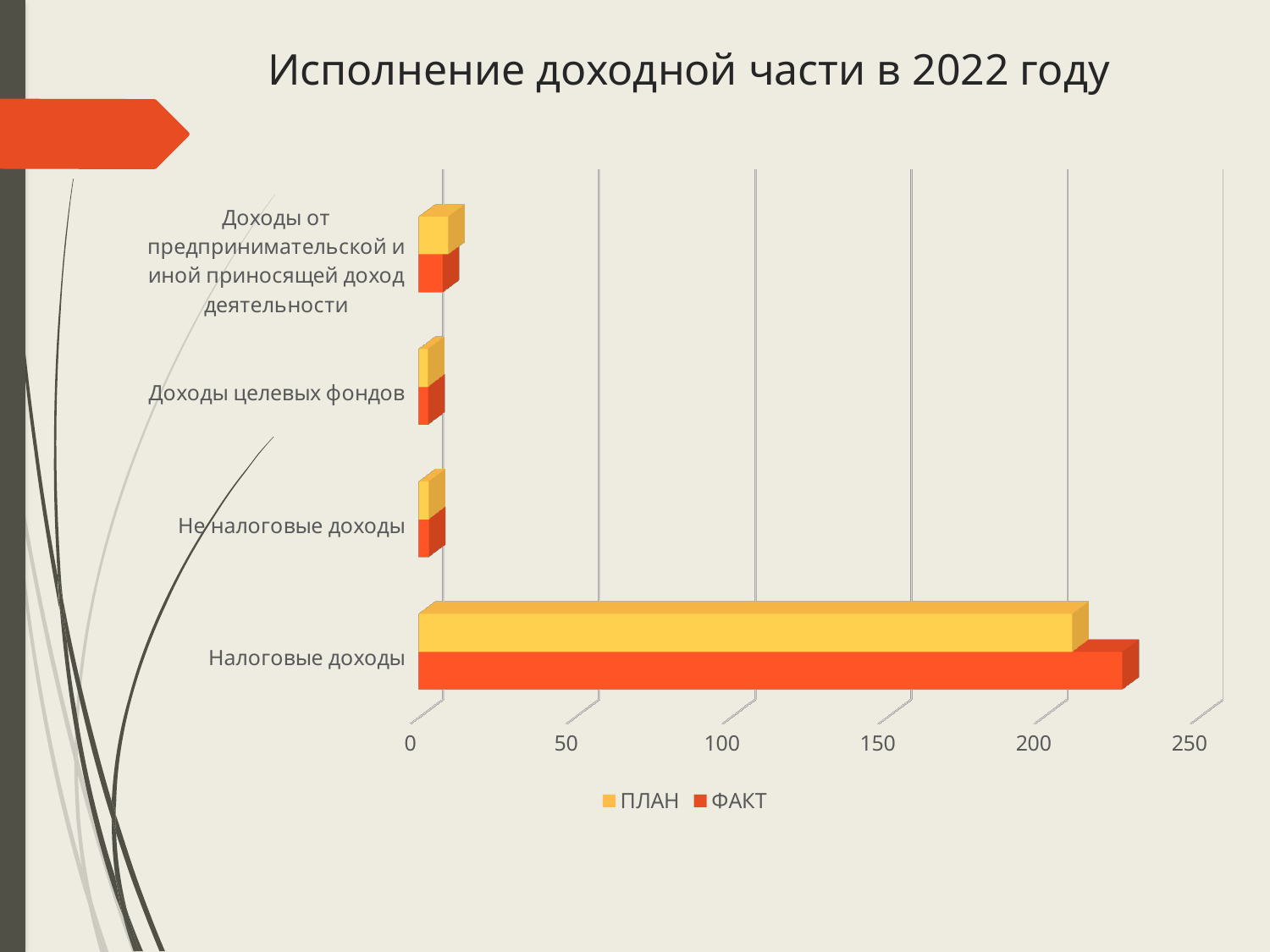
Is the ФАКТ value for Не налоговые доходы greater or less than 50? less Which category has the highest ПЛАН value? Налоговые доходы Which category has the highest ФАКТ value? Налоговые доходы Is the ПЛАН value for Налоговые доходы greater or less than 200? greater Is the ПЛАН value for Доходы целевых фондов greater or less than 50? less How many categories are shown on the chart? 4 How many series does the legend list? 2 For Налоговые доходы, which is larger: ПЛАН or ФАКТ? ФАКТ What kind of chart is shown on the slide? bar chart Which series is shown in orange-red bars? ФАКТ What is the title of the chart? Исполнение доходной части в 2022 году